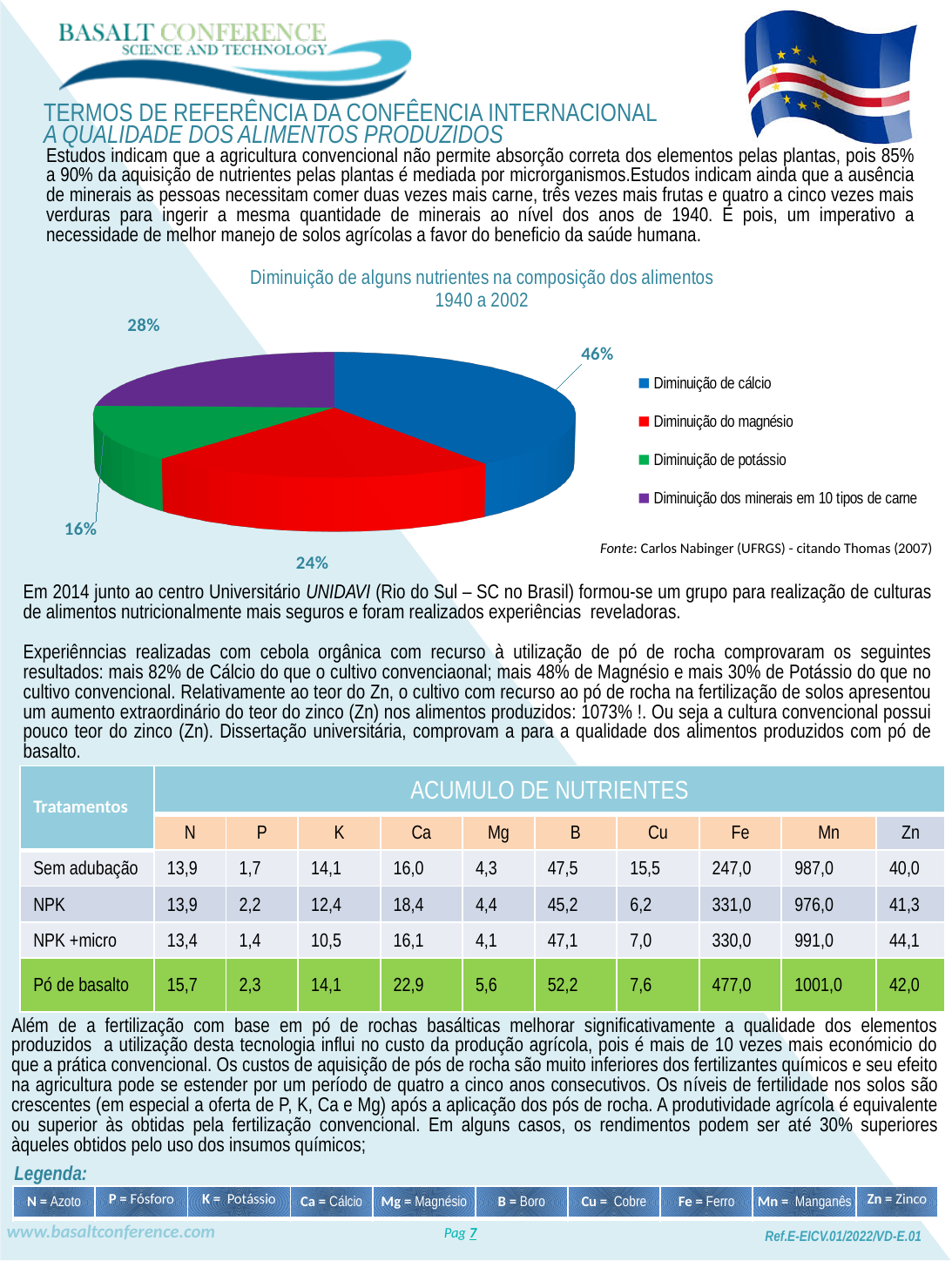
Which is larger in the pie chart: 'Diminuição dos minerais em 10 tipos de carne' or 'Diminuição do magnésio'? Diminuição dos minerais em 10 tipos de carne What colour is the slice for 'Diminuição de potássio'? green How many slices does the pie chart have? 4 Which category has the smallest slice in the pie chart? Diminuição de potássio What percentage is shown for 'Diminuição do magnésio' in the pie chart? 24% What percentage is shown for 'Diminuição de cálcio' in the pie chart? 46% What percentage is shown for 'Diminuição dos minerais em 10 tipos de carne' in the pie chart? 28% What kind of chart is shown on the slide? pie chart What is the difference between the percentages for 'Diminuição de cálcio' and 'Diminuição do magnésio'? 22% What percentage is shown for 'Diminuição de potássio' in the pie chart? 16% Which category has the largest slice in the pie chart? Diminuição de cálcio What is the title of the pie chart? Diminuição de alguns nutrientes na composição dos alimentos 1940 a 2002